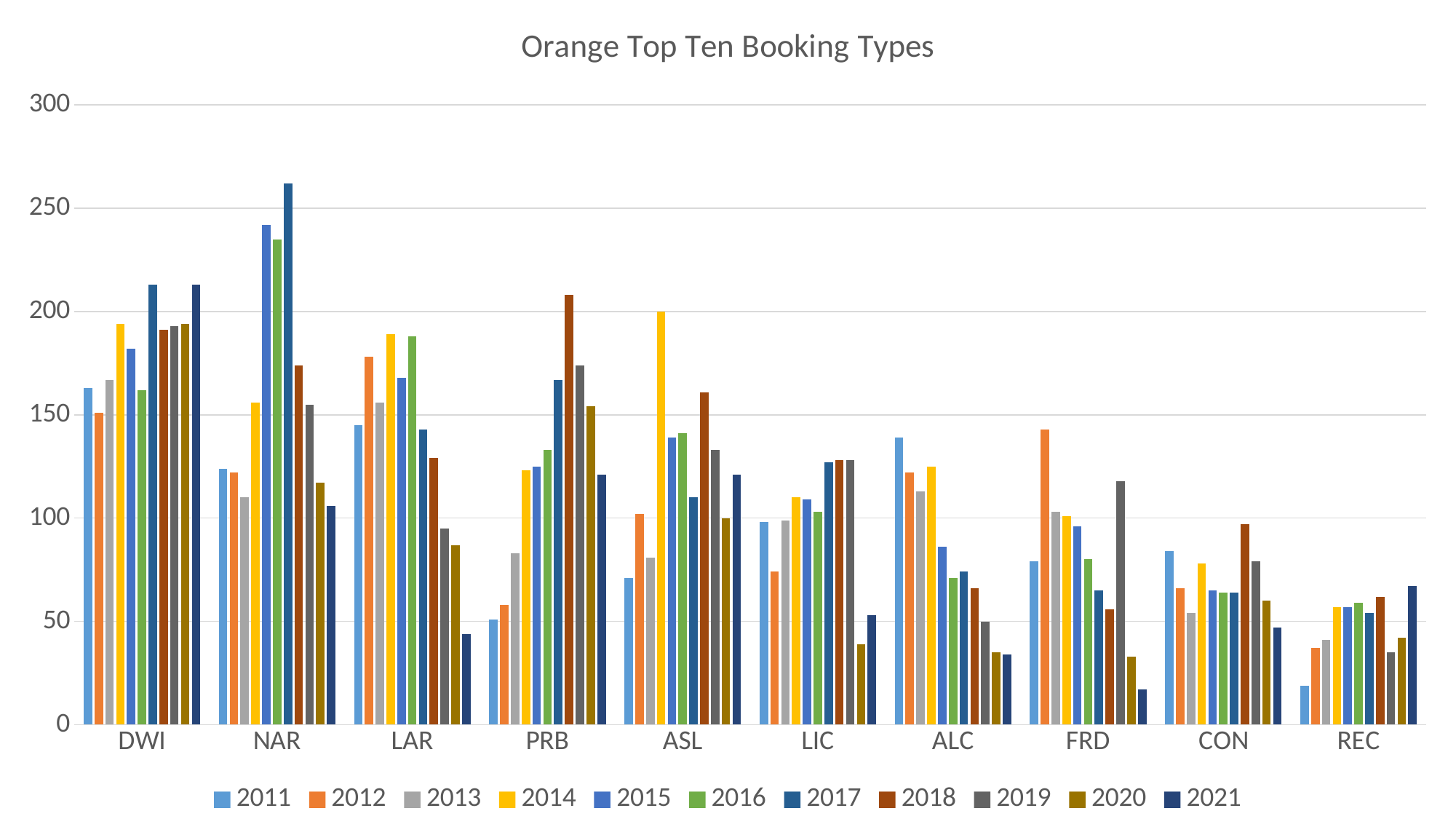
Which is larger for 2011: DWI or NAR? DWI Is the value for REC in 2011 greater or less than 50? less Which year has the highest value for FRD? 2012 Which year has the highest value for ASL? 2014 Which category and year has the tallest bar in the chart? NAR, 2017 Is the value for PRB in 2018 greater or less than 200? greater How many series does the legend list? 11 What is the title of the chart? Orange Top Ten Booking Types Which year has the lowest value for LIC? 2020 Is the value for NAR in 2017 greater or less than 250? greater What kind of chart is shown on the slide? bar chart How many booking type categories are shown on the x axis? 10